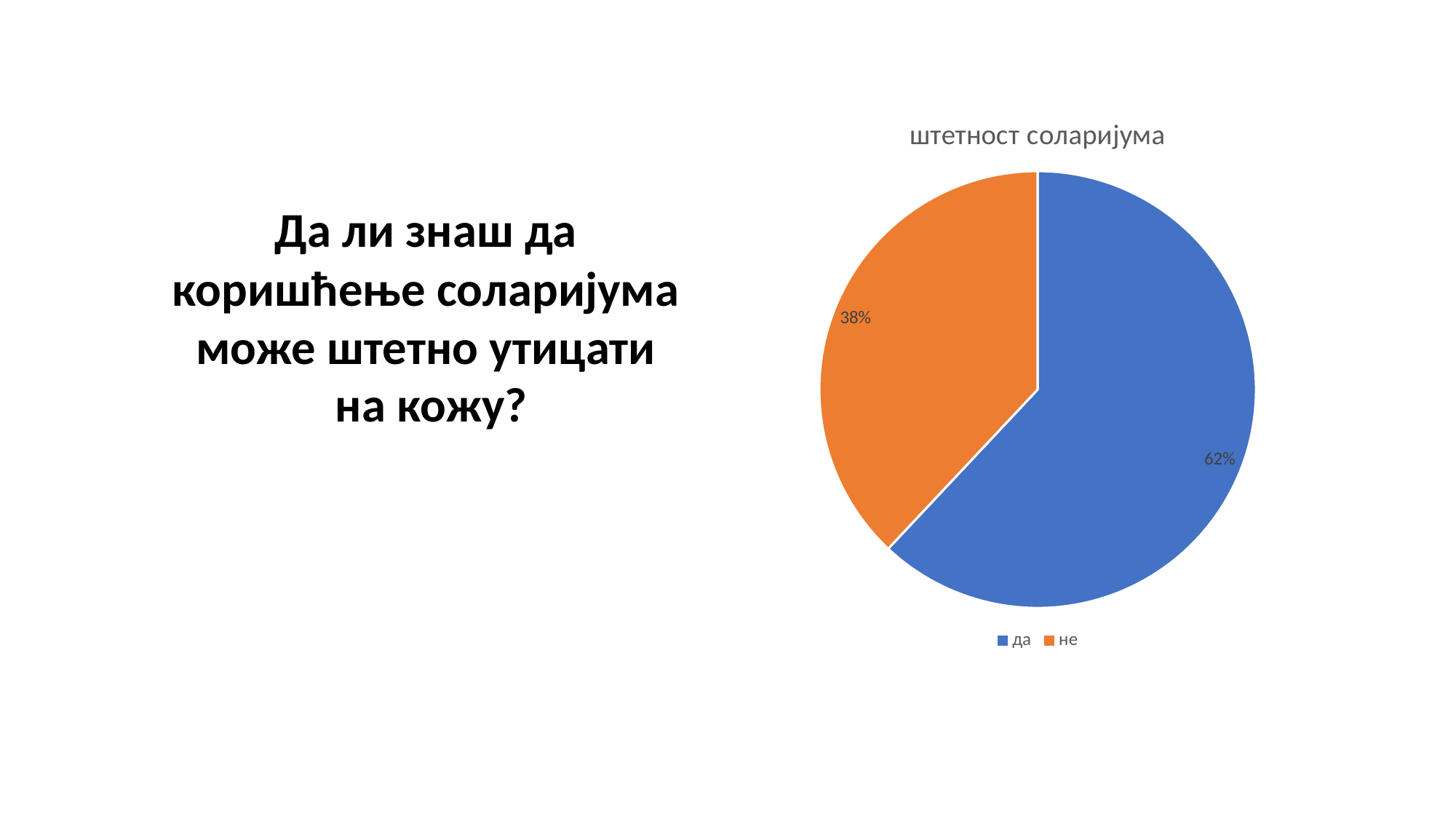
What is the title of the chart? штетност соларијума What share of the pie does "да" take? 62% What is the difference in percentage points between the "да" and "не" slices? 24 Which slice is the largest? да How many entries does the legend list? 2 What colour is the "не" slice? orange Which is larger, the "да" slice or the "не" slice? да What share of the pie does "не" take? 38% Which slice is the smallest? не How many slices does the pie chart have? 2 What kind of chart is shown on the slide? pie chart